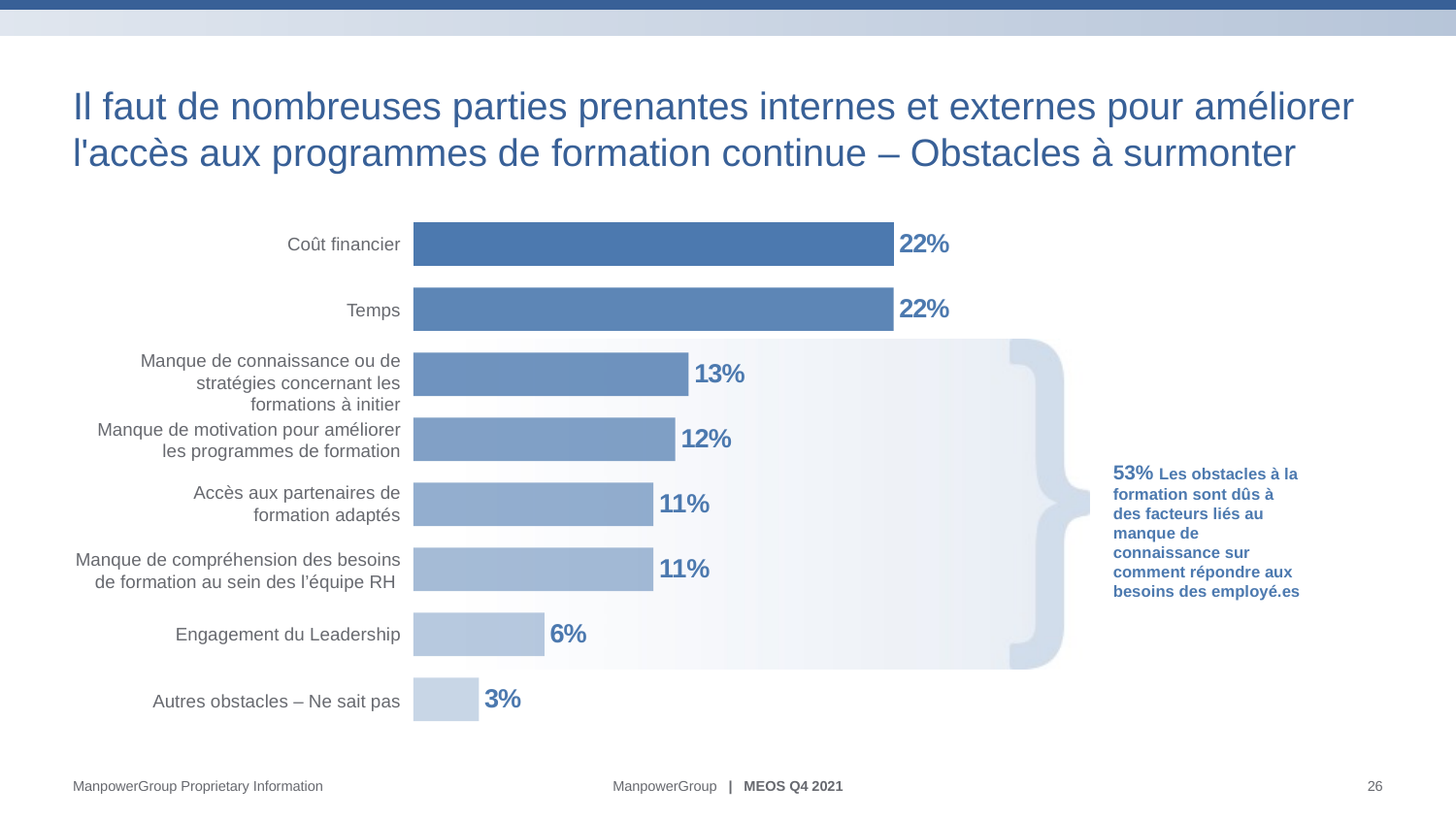
What is the value for Accès aux partenaires de formation adaptés? 11% How many categories are plotted in the chart? 8 What kind of chart is shown on the slide? bar chart What is the value for Engagement du Leadership? 6% Which is larger, the value for Engagement du Leadership or the value for Autres obstacles – Ne sait pas? Engagement du Leadership What is the value for Manque de motivation pour améliorer les programmes de formation? 12% Which category has the lowest value? Autres obstacles – Ne sait pas What percentage does the callout text next to the bracket give for obstacles due to factors linked to a lack of knowledge? 53% What is the value for Coût financier? 22% Do the bar values increase or decrease from the top of the chart to the bottom? decrease What is the difference between the value for Manque de connaissance ou de stratégies concernant les formations à initier and the value for Engagement du Leadership? 7 percentage points What is the difference between the value for Temps and the value for Autres obstacles – Ne sait pas? 19 percentage points